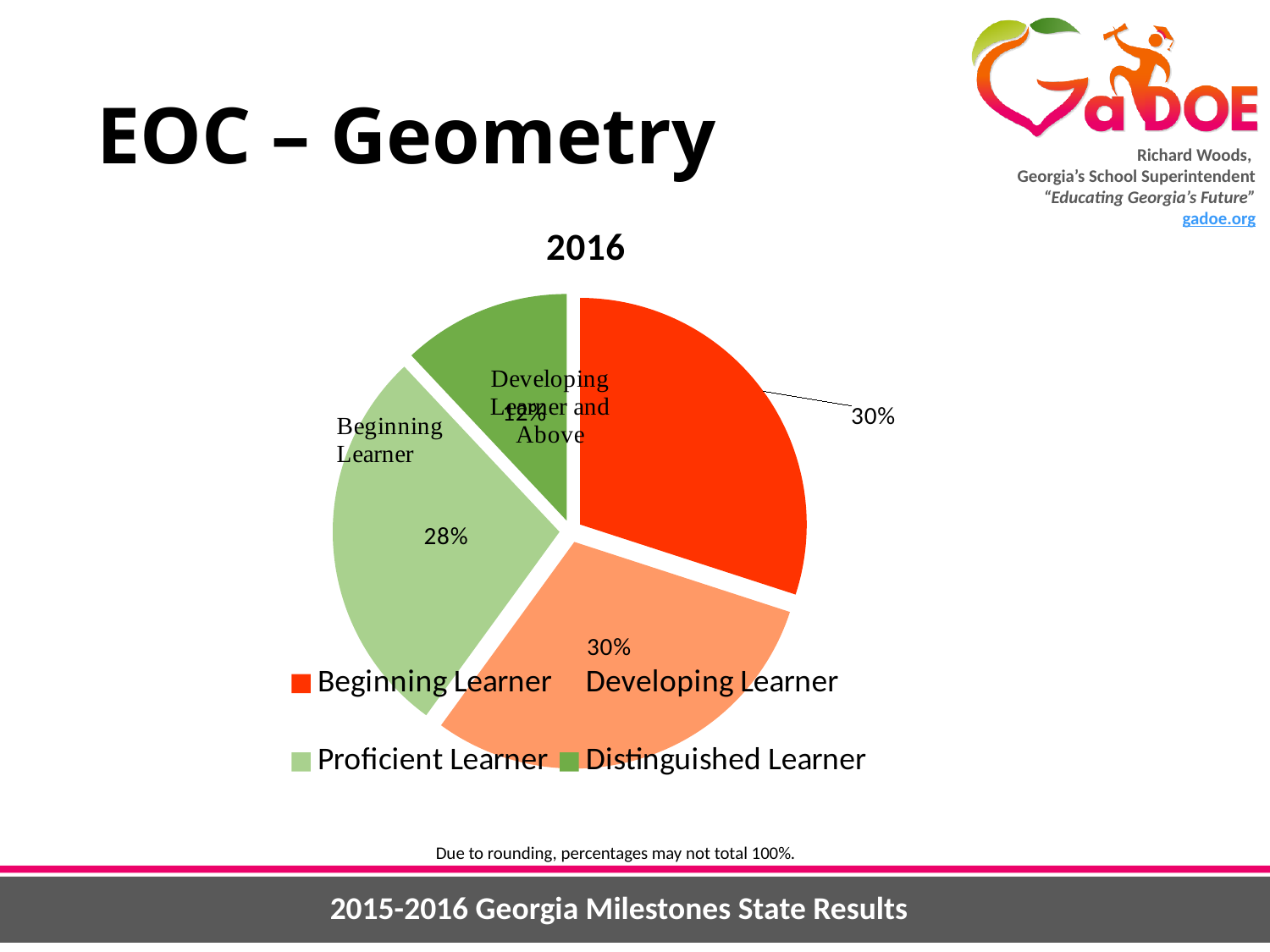
What kind of chart is shown on the slide? pie chart What percentage of the pie is Proficient Learner? 28% What percentage of the pie is Distinguished Learner? 12% Which category has the smallest slice of the pie? Distinguished Learner Which is larger, the Proficient Learner slice or the Distinguished Learner slice? Proficient Learner How many entries does the legend list? 4 How many slices does the pie chart have? 4 What is the difference in percentage points between the Beginning Learner slice and the Distinguished Learner slice? 18 What percentage of the pie is Beginning Learner? 30% What is the difference in percentage points between the Developing Learner slice and the Proficient Learner slice? 2 What percentage of the pie is Developing Learner? 30% What is the title of the pie chart? 2016